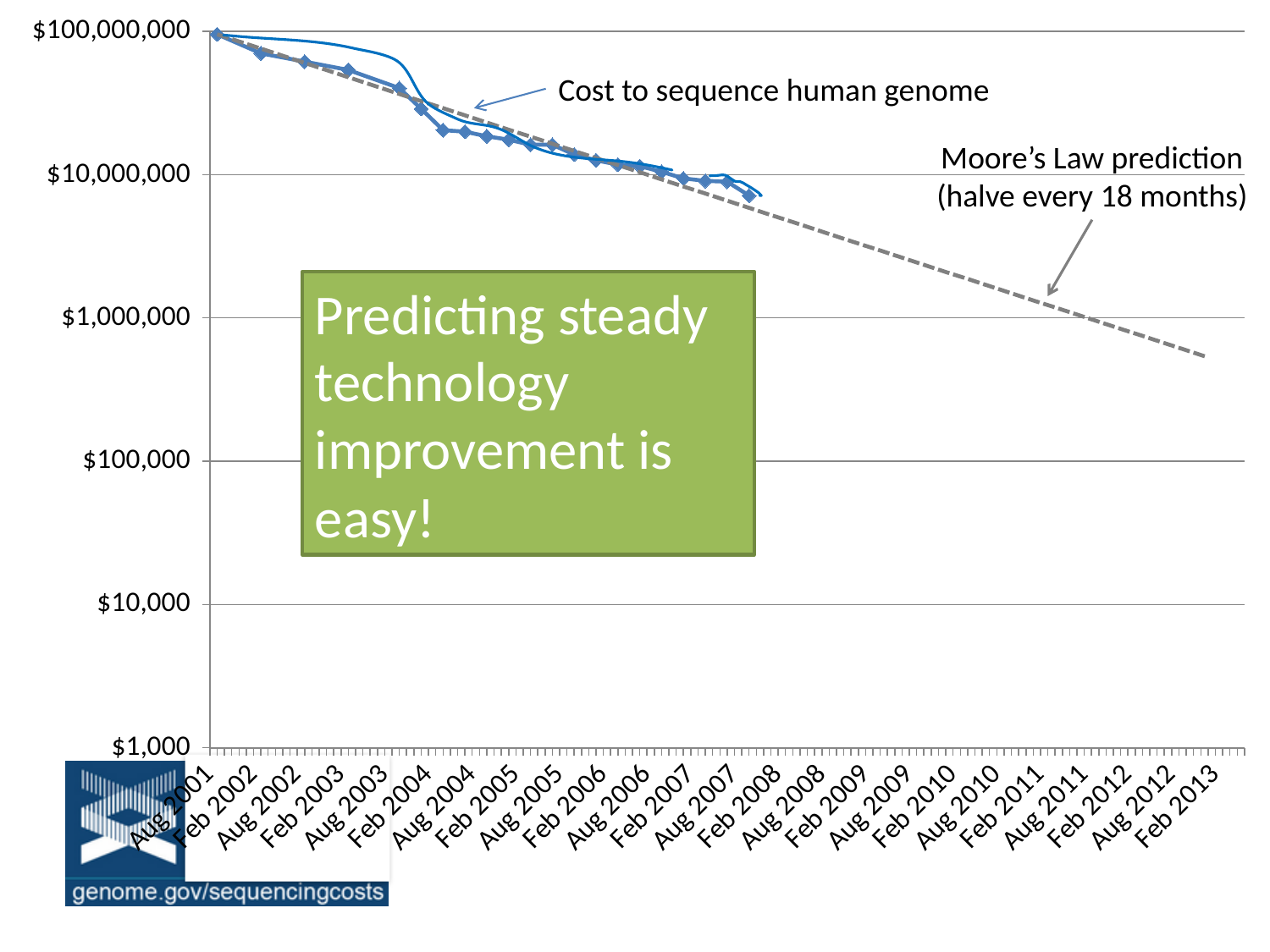
What does the dashed grey line on the chart represent? Moore's Law prediction (halve every 18 months) What is the highest value labelled on the y axis? $100,000,000 What kind of chart is shown on the slide? line chart How many data series are plotted on the chart? 2 Is the Moore's Law prediction value at Feb 2013 greater or less than $1,000,000? less Is the cost to sequence a human genome in Feb 2008 greater or less than $10,000,000? less At Feb 2008, which is higher: the actual cost to sequence a human genome or the Moore's Law prediction? the actual cost to sequence a human genome Is the Moore's Law prediction value at Feb 2013 greater or less than $100,000? greater How many date labels are shown on the x axis? 24 Does the cost to sequence a human genome rise or fall over time along the x axis? fall